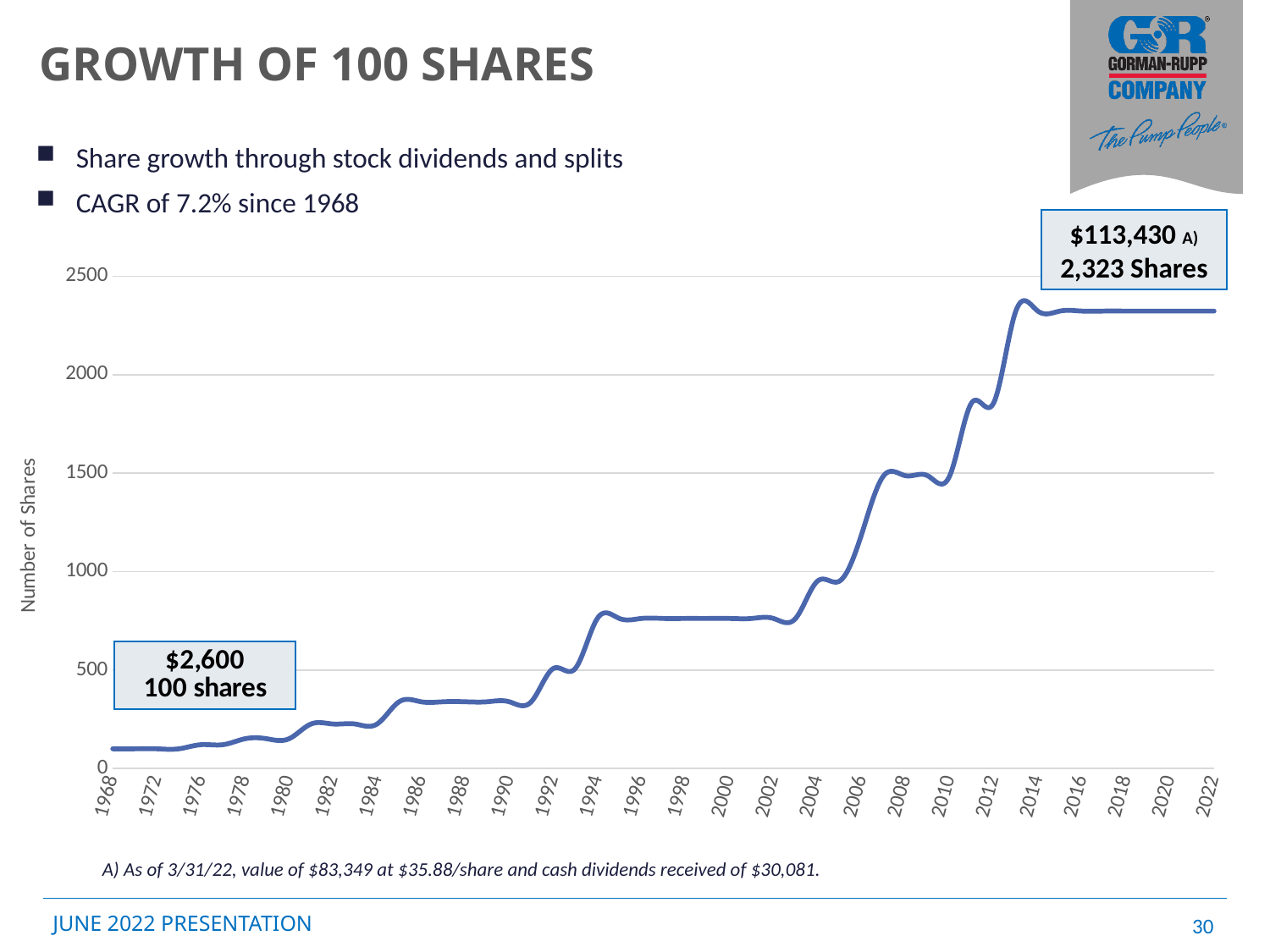
How many shares does the chart show at the start of the series in 1968? 100 shares By how many shares did the holding grow from 100 shares in 1968 to 2,323 shares in 2022? 2,223 What dollar value is shown for the 2,323 shares at the end of the chart? $113,430 What dollar value is shown for the 100 shares at the start of the chart? $2,600 What is the label on the vertical axis of the chart? Number of Shares Is the number of shares in 2000 greater or less than 1000? less Is the number of shares in 2014 greater or less than 2000? greater Is the number of shares in 1990 greater or less than 500? less Does the number of shares generally rise or fall from 1968 to 2022? Rise What is the title of the chart on the slide? Growth of 100 Shares How many shares does the chart show at the end of the series in 2022? 2,323 Shares What kind of chart is shown on the slide? Line chart